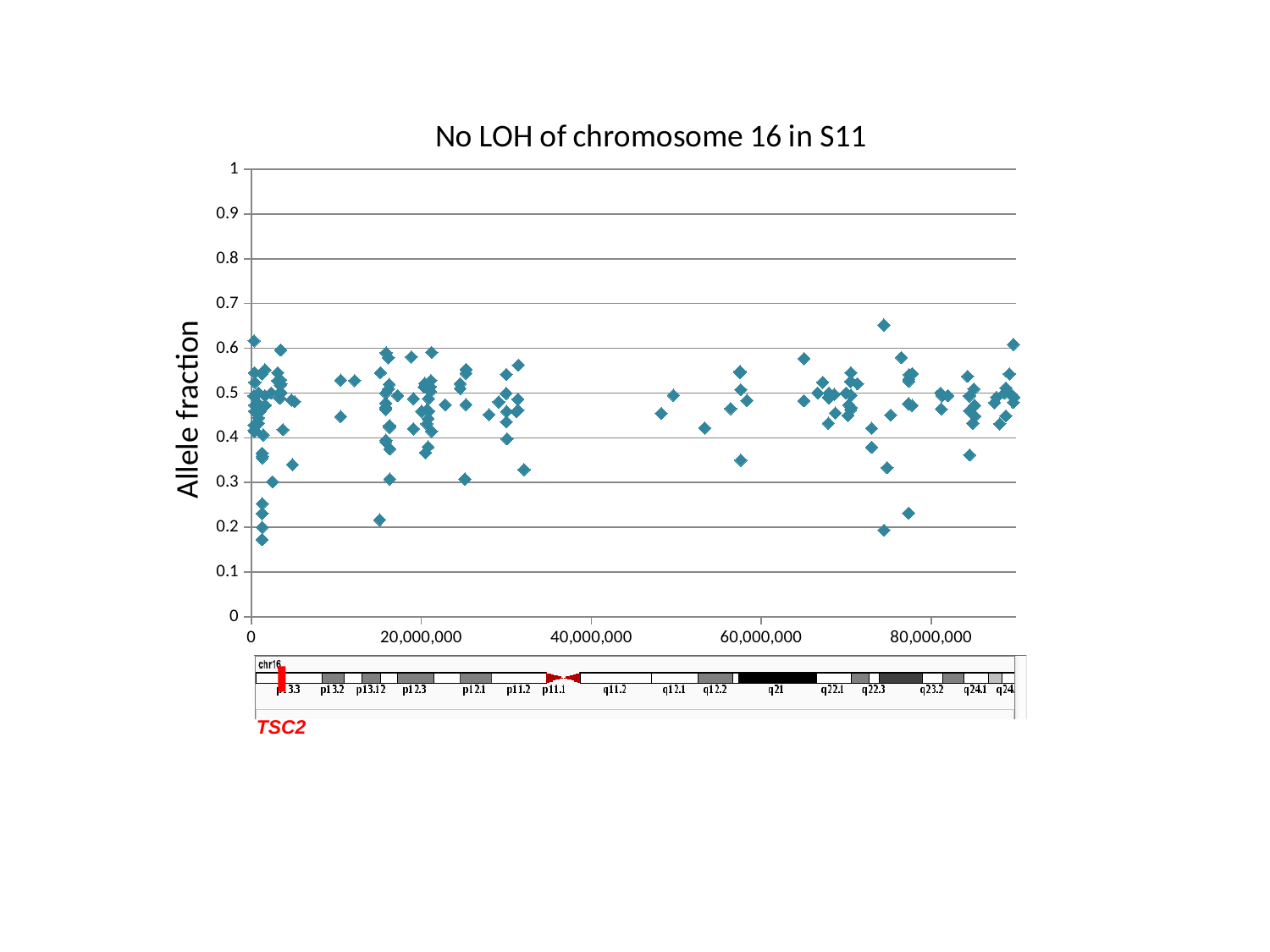
What kind of chart is shown on the slide? Scatter plot Is the highest plotted allele fraction greater or less than 0.7? less What is the label of the y axis? Allele fraction Is the lowest plotted allele fraction greater or less than 0.1? greater Is any plotted point greater than 0.7 on the y axis? No What is the maximum value shown on the y axis? 1 What is the title of the chart? No LOH of chromosome 16 in S11